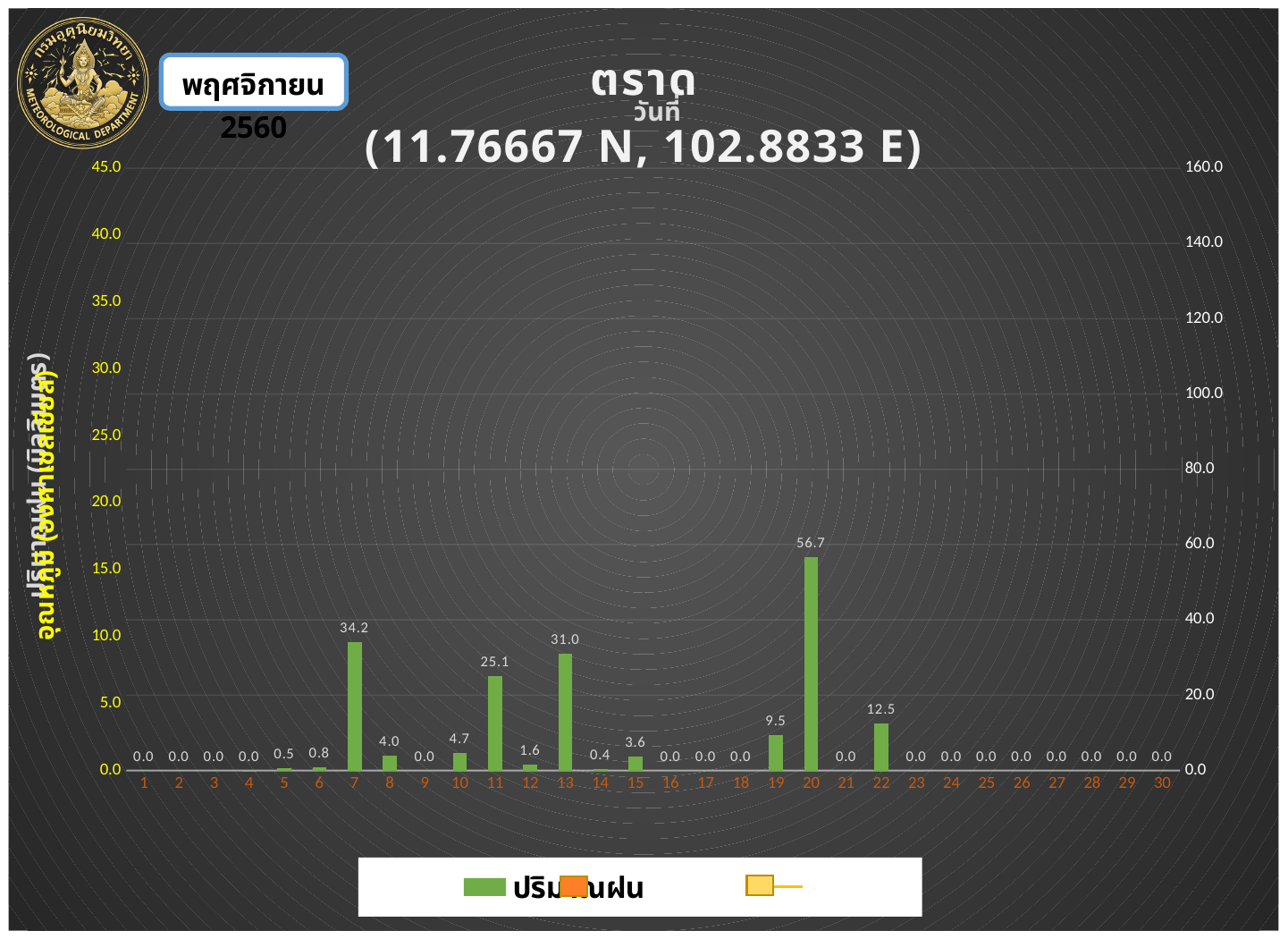
What is the difference between the rainfall values for day 13 and day 11? 5.9 What kind of chart is shown on the slide? bar chart Which day has the highest rainfall value? 20 What is the rainfall value shown for day 20? 56.7 What is the difference between the rainfall values for day 20 and day 7? 22.5 Which is larger, the rainfall value for day 19 or for day 22? day 22 What is the rainfall value shown for day 13? 31.0 What is the rainfall value shown for day 11? 25.1 What is the title of the chart? ตราด (11.76667 N, 102.8833 E) What is the rainfall value shown for day 7? 34.2 How many days are shown on the x axis of the chart? 30 What is the rainfall value shown for day 22? 12.5